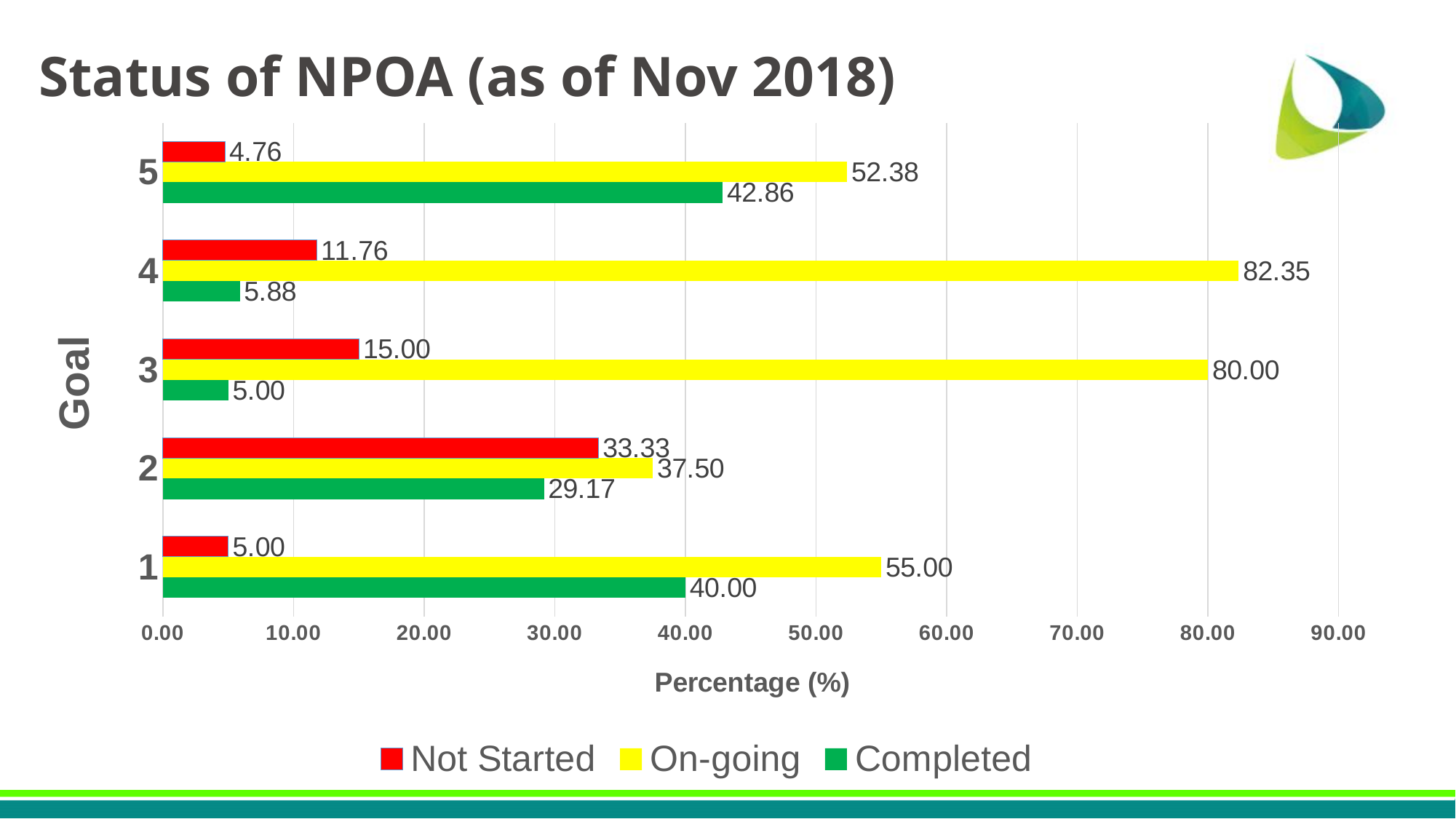
Which is larger for Goal 2: the On-going percentage or the Completed percentage? On-going What is the title of the chart? Status of NPOA (as of Nov 2018) What is the Not Started percentage for Goal 2? 33.33 What is the difference between the On-going and Completed percentages for Goal 5? 9.52 Which goal has the highest On-going percentage? 4 What kind of chart is shown on the slide? Bar chart Is the On-going value for Goal 3 greater or less than 70.00? greater What is the On-going percentage for Goal 4? 82.35 Which goal has the lowest Completed percentage? 3 How many series does the legend list? 3 How many goals are shown on the chart? 5 What is the Completed percentage for Goal 1? 40.00